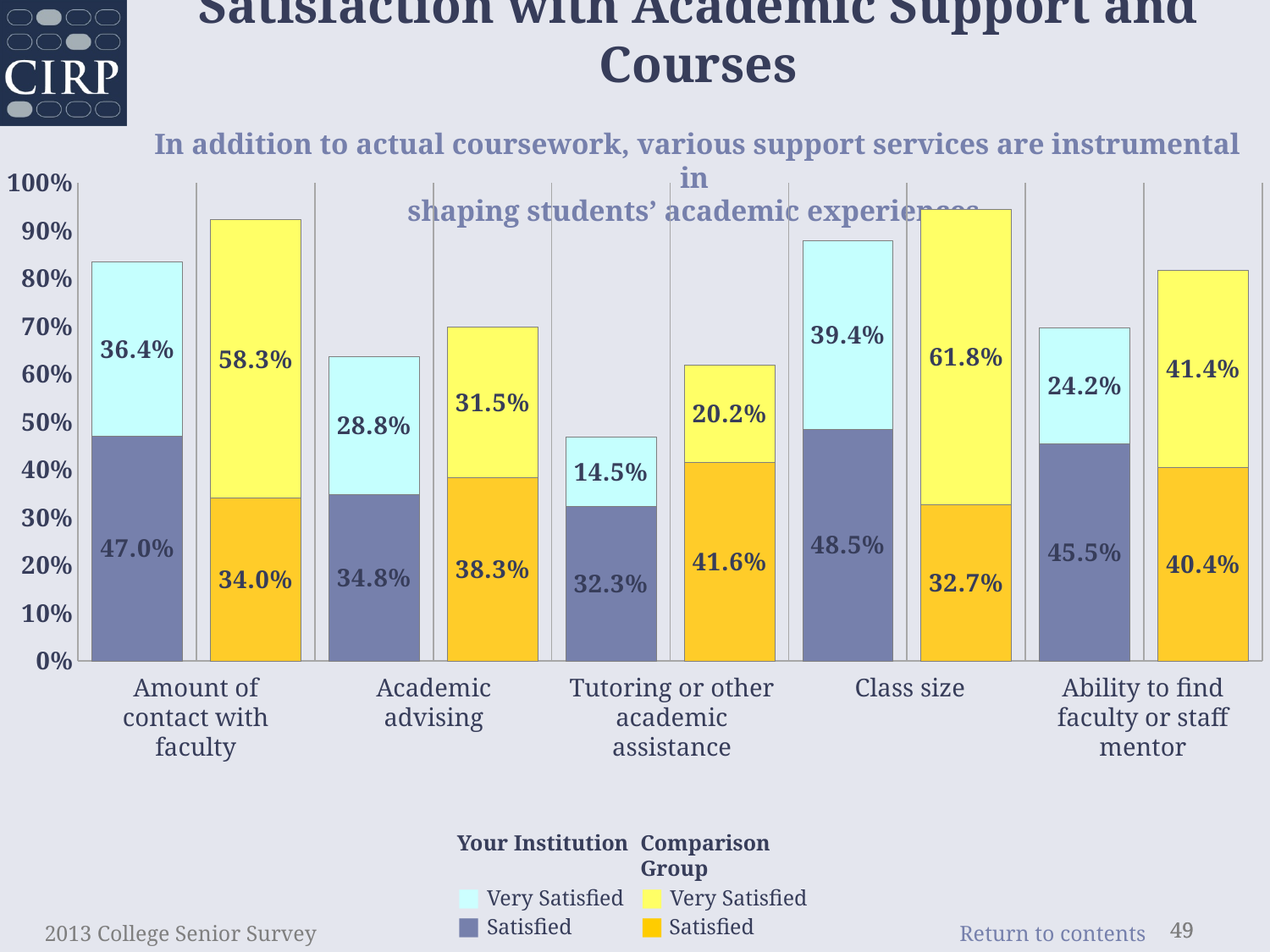
What is the total height of the Your Institution stacked bar for Class size? 87.9% What percentage of the Comparison Group was Satisfied with Tutoring or other academic assistance? 41.6% What percentage of Your Institution students were Very Satisfied with Amount of contact with faculty? 36.4% What kind of chart is shown on the slide? Stacked bar chart What is the Comparison Group Very Satisfied value for Class size? 61.8% How many categories are shown on the x axis? 5 How many series does the legend list? 4 Which category has the lowest Your Institution Very Satisfied value? Tutoring or other academic assistance What is the difference between the Comparison Group Very Satisfied value and the Your Institution Very Satisfied value for Amount of contact with faculty? 21.9% For Academic advising, which is larger: the Your Institution Satisfied value or the Comparison Group Satisfied value? Comparison Group Satisfied Which category has the highest Your Institution Satisfied value? Class size What is the total height of the Comparison Group stacked bar for Ability to find faculty or staff mentor? 81.8%